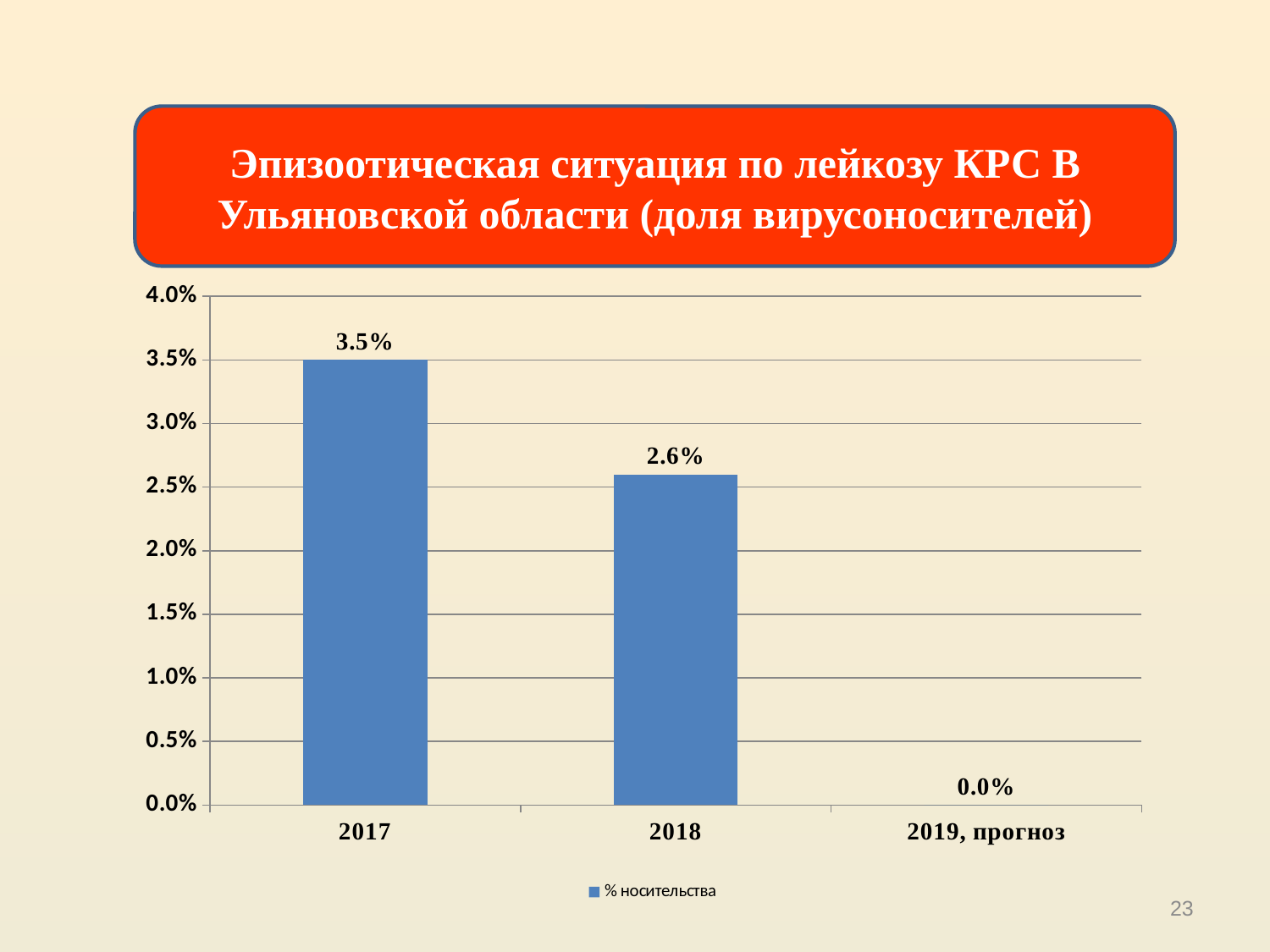
How many categories are shown on the x axis? 3 Which category has the lowest value? 2019, прогноз What is the difference between the values for 2017 and 2018? 0.9% Which is larger, the value for 2017 or the value for 2018? 2017 What is the value for 2017? 3.5% What kind of chart is shown on the slide? bar chart How many series does the legend list? 1 Do the values rise or fall from 2017 to 2019, прогноз? fall Which category has the highest value? 2017 Is the value for 2018 greater or less than 3.0%? less What is the value for 2019, прогноз? 0.0% What is the value for 2018? 2.6%